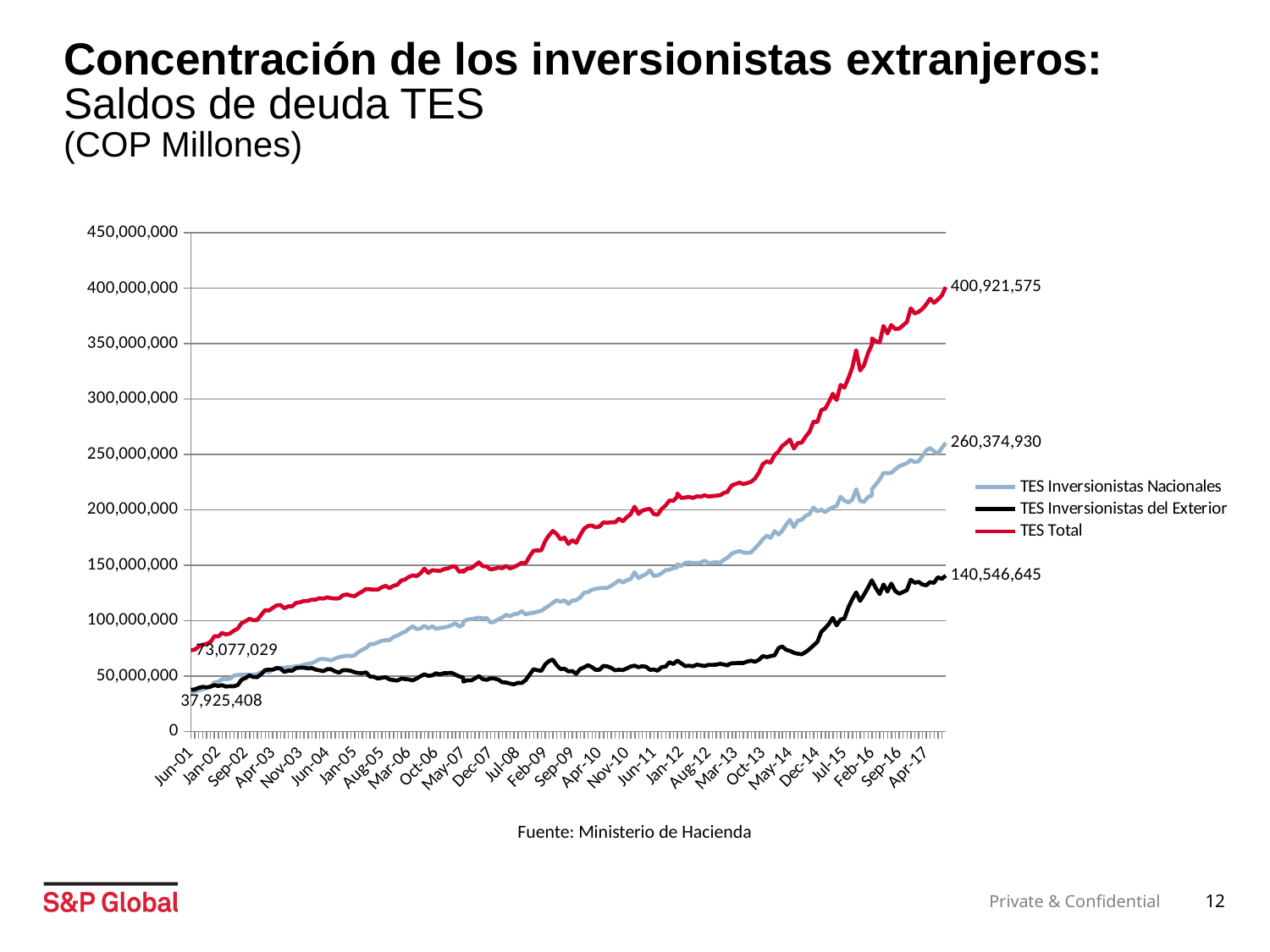
What is the labelled starting value (Jun-01) of the TES Inversionistas del Exterior series? 37,925,408 What is the difference between the final labelled values of TES Total and TES Inversionistas Nacionales? 140,546,645 How many series does the legend list? 3 Which series has the lowest value at the end of the chart? TES Inversionistas del Exterior What kind of chart is shown on the slide? Line chart What is the final labelled value of the TES Inversionistas Nacionales series? 260,374,930 What is the final labelled value of the TES Inversionistas del Exterior series? 140,546,645 What is the final labelled value of the TES Total series? 400,921,575 What is the labelled starting value (Jun-01) of the TES Total series? 73,077,029 By how much did the TES Total series increase from its labelled starting value to its labelled final value? 327,844,546 Which series has the highest value at the end of the chart? TES Total Is the value of TES Inversionistas del Exterior at Jan-12 greater or less than 100,000,000? less